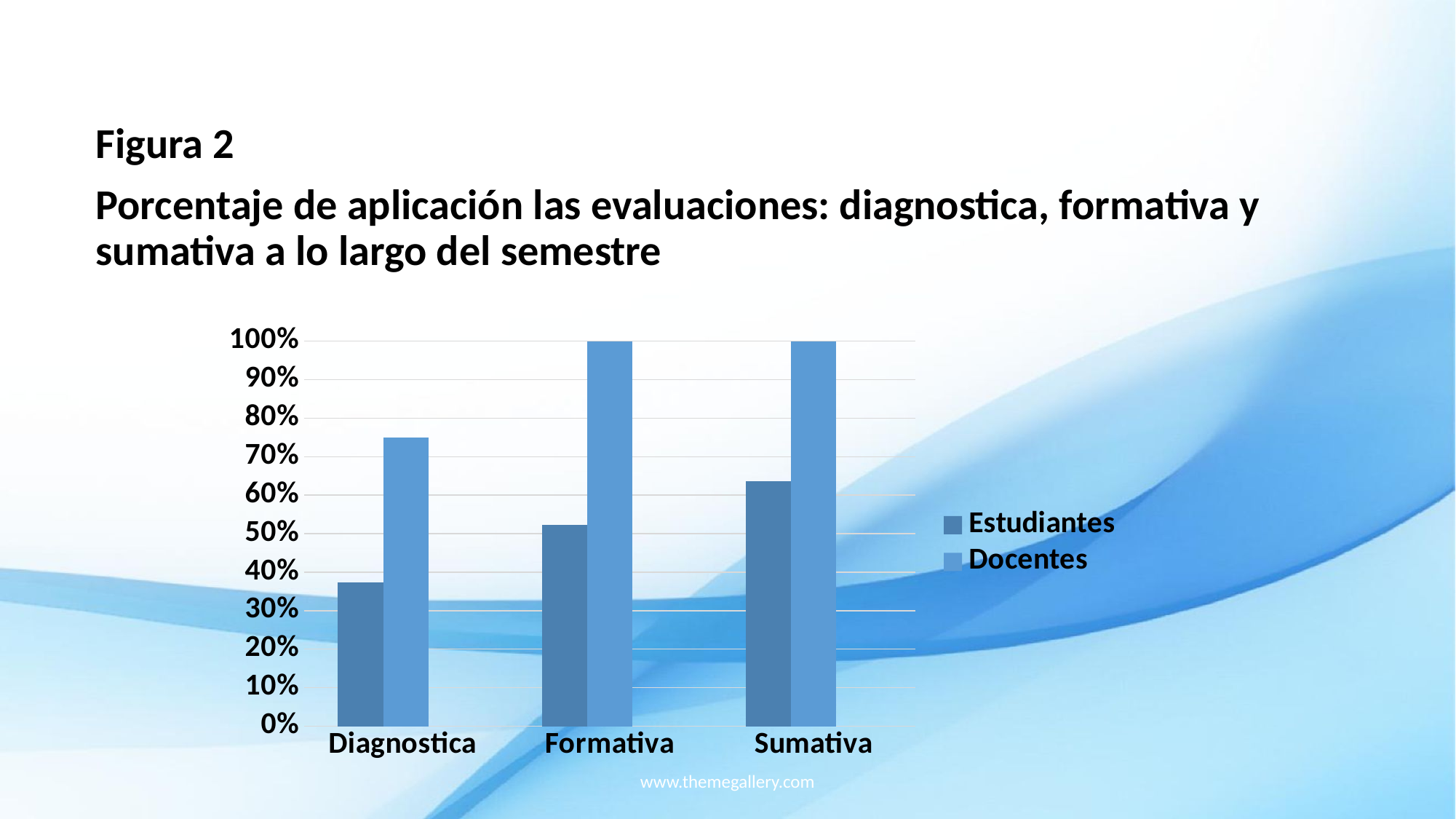
Which category has the lowest Docentes value? Diagnostica Do the Estudiantes values rise or fall from Diagnostica to Sumativa? rise Is the Estudiantes value for Diagnostica greater or less than 40%? less Which category has the highest Estudiantes value? Sumativa How many categories are shown on the x axis? 3 What is the Docentes value for Formativa? 100% What is the Docentes value for Sumativa? 100% Is the Docentes value for Diagnostica greater or less than 70%? greater How many series does the legend list? 2 What kind of chart is shown on the slide? bar chart Is the Estudiantes value for Sumativa greater or less than 60%? greater For Diagnostica, which is larger: the Estudiantes value or the Docentes value? Docentes